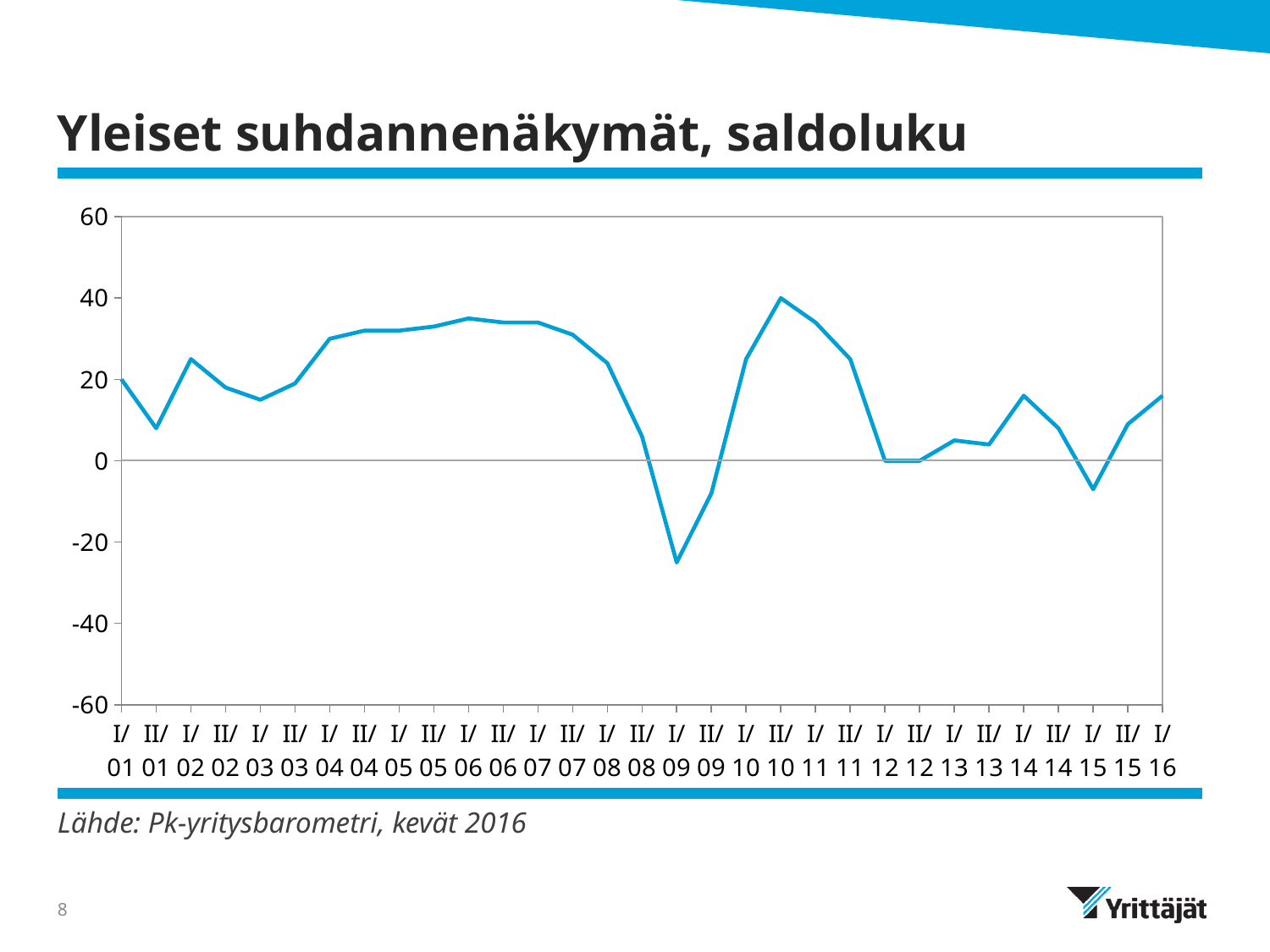
Which period has the lowest value? I/09 Which period has the highest value? II/10 Is the value for II/10 greater or less than 20? greater What kind of chart is shown on the slide? line chart Does the line rise or fall between I/08 and I/09? fall How many time points are plotted on the x axis? 31 What is the title of the chart? Yleiset suhdannenäkymät, saldoluku Is the value for I/04 greater or less than 20? greater Is the value for I/15 greater or less than 0? less Which is larger, the value for I/06 or the value for I/09? I/06 Which is larger, the value for I/01 or the value for II/01? I/01